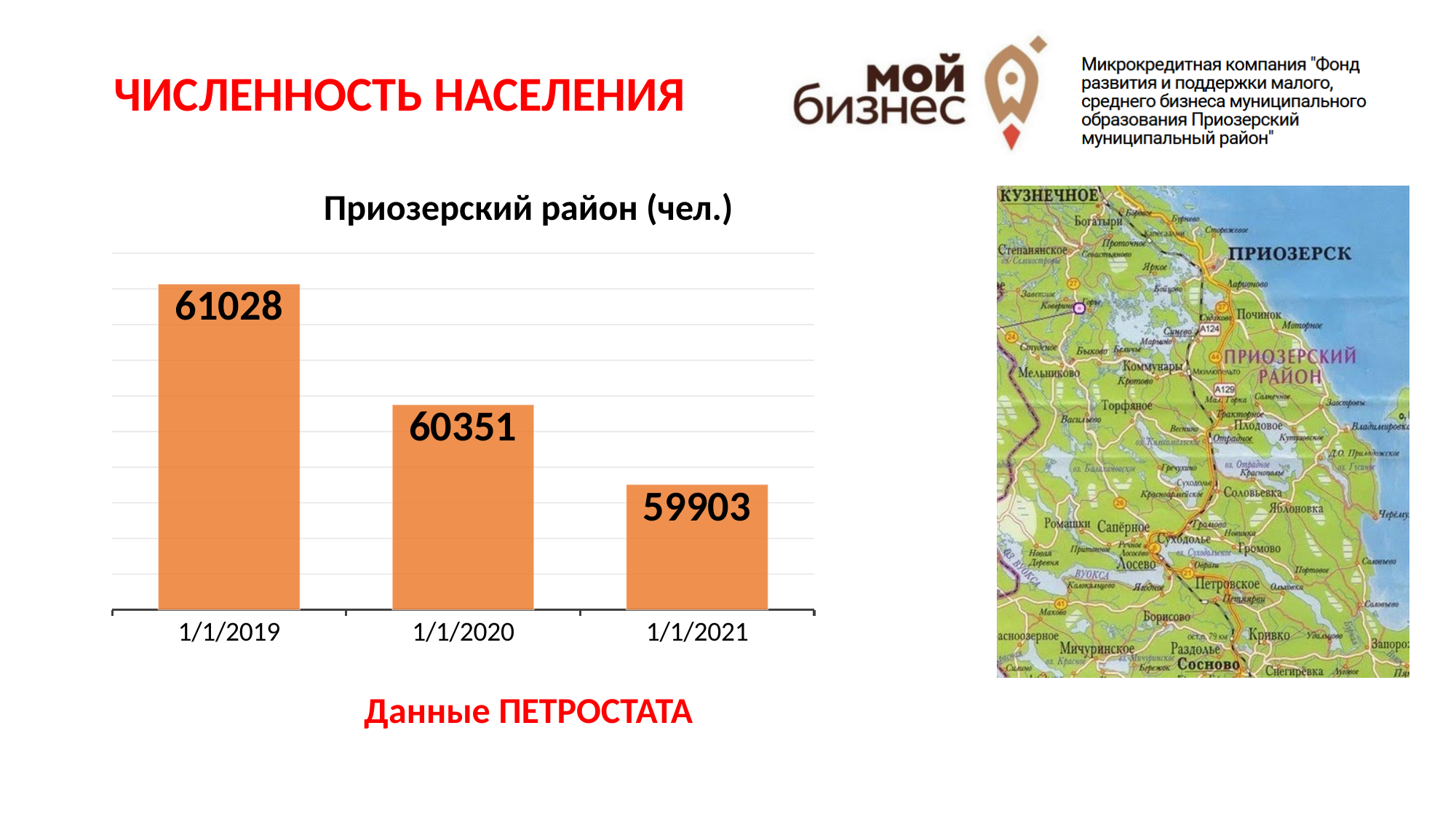
What kind of chart is shown on the slide? bar chart Which date has the lowest population value? 1/1/2021 Which date has the highest population value? 1/1/2019 What is the population value shown for 1/1/2020? 60351 Do the values rise or fall from 1/1/2019 to 1/1/2021? fall What is the population value shown for 1/1/2019? 61028 Which is larger, the value for 1/1/2020 or the value for 1/1/2021? 1/1/2020 What is the difference between the values for 1/1/2019 and 1/1/2021? 1125 What is the difference between the values for 1/1/2019 and 1/1/2020? 677 What is the title of the chart? Приозерский район (чел.) What is the population value shown for 1/1/2021? 59903 How many dates are shown on the x axis of the chart? 3